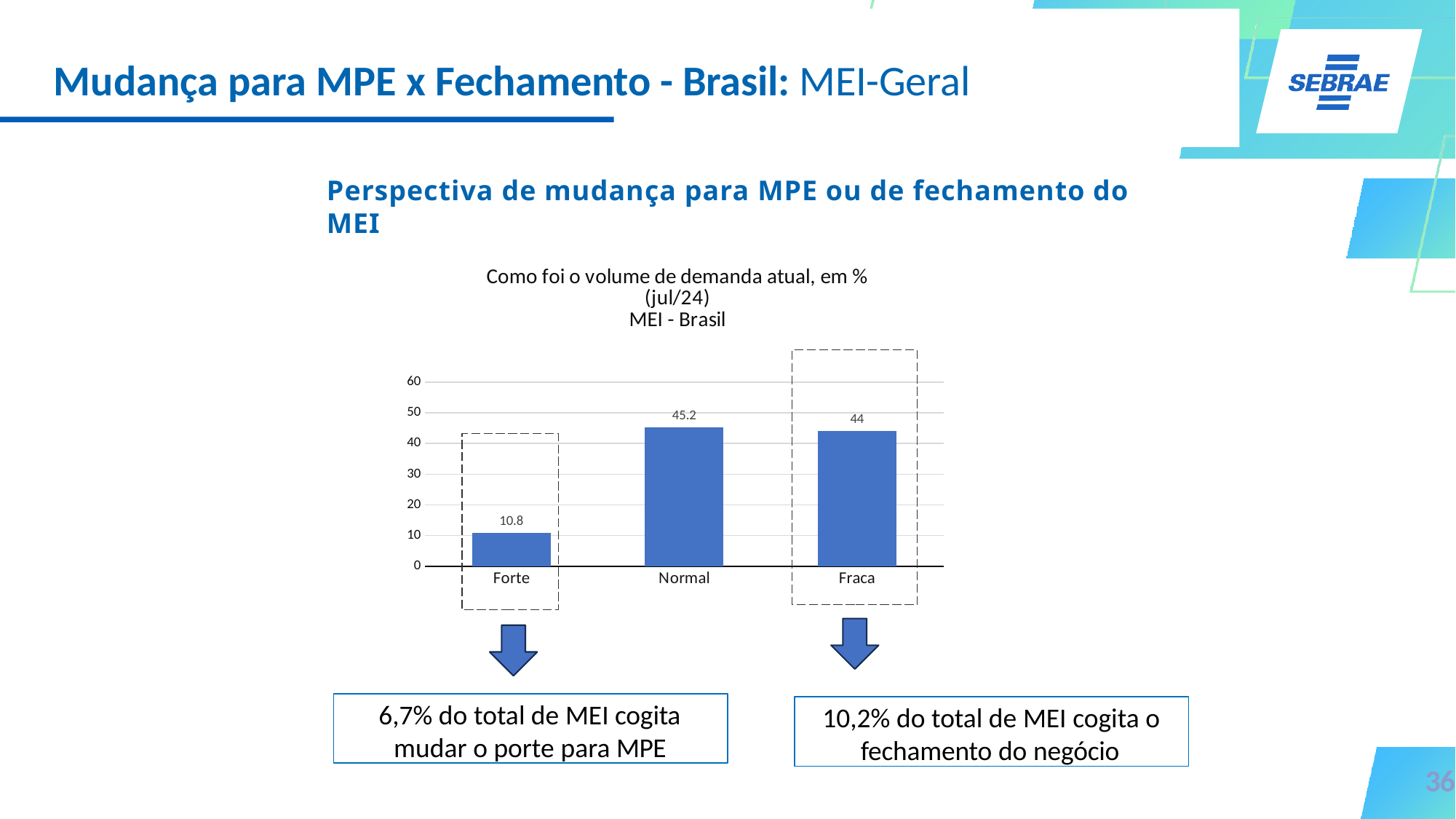
What is the value for Fraca? 44 How many categories are shown on the x axis? 3 What kind of chart is shown on the slide? bar chart Which is larger, the value for Forte or the value for Fraca? Fraca What is the difference between the values for Fraca and Forte? 33.2 What is the difference between the values for Normal and Forte? 34.4 What is the title of the chart? Como foi o volume de demanda atual, em % (jul/24) MEI - Brasil Which category has the lowest value? Forte What is the value for Forte? 10.8 Is the value for Forte greater or less than 20? less What is the value for Normal? 45.2 Which category has the highest value? Normal